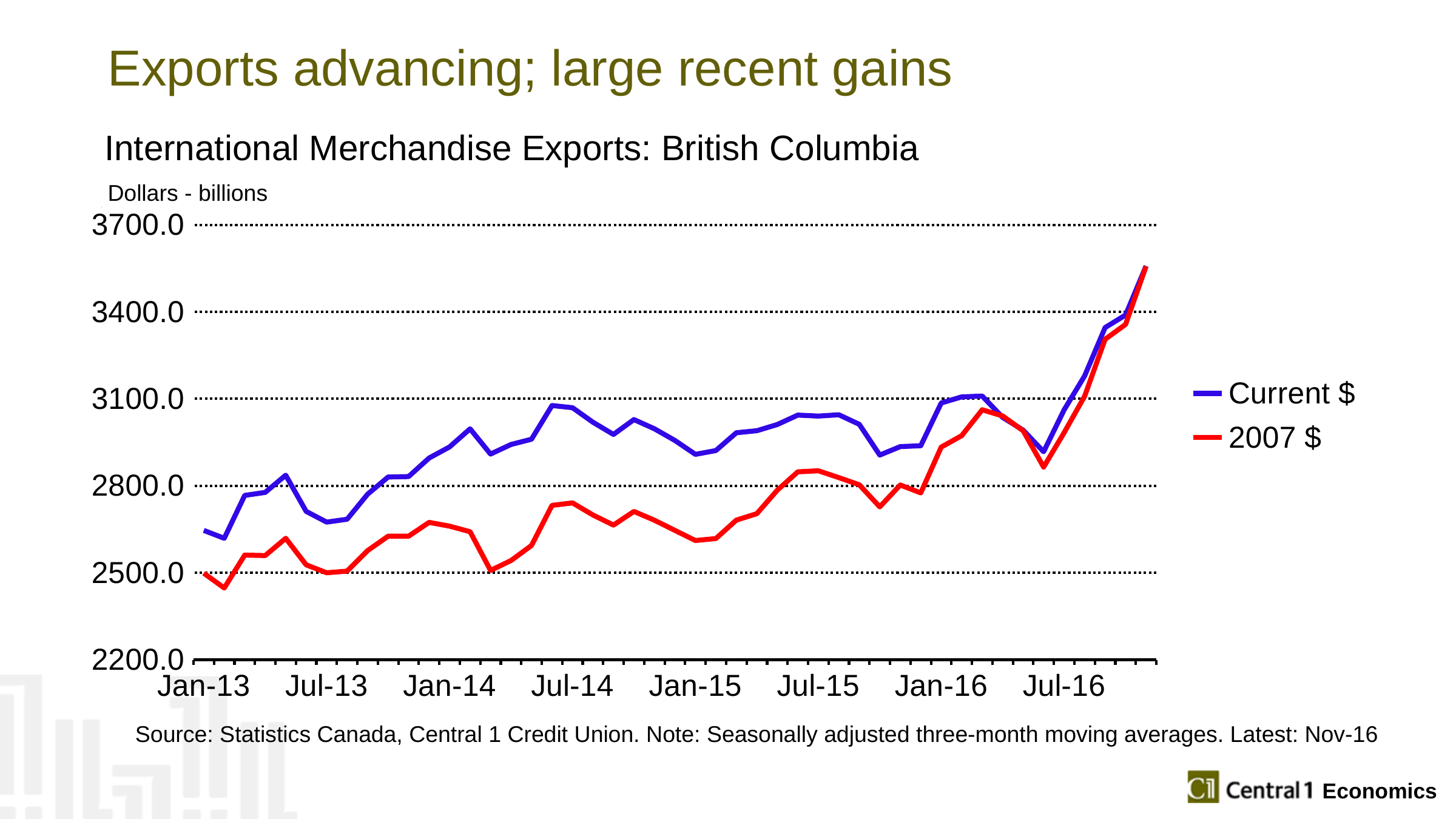
Is the Current $ value at Jan-13 greater or less than 2500? greater How many series does the legend list? 2 What are the two series named in the legend? Current $ and 2007 $ Is the Current $ value at Jan-13 greater or less than 2800? less At Jan-14, which series has the larger value, Current $ or 2007 $? Current $ Is the Current $ value at Jan-15 greater or less than 2800? greater What kind of chart is shown on the slide? line chart What is the title of the chart? International Merchandise Exports: British Columbia Do the Current $ values generally rise or fall from Jan-13 to the end of the series? rise